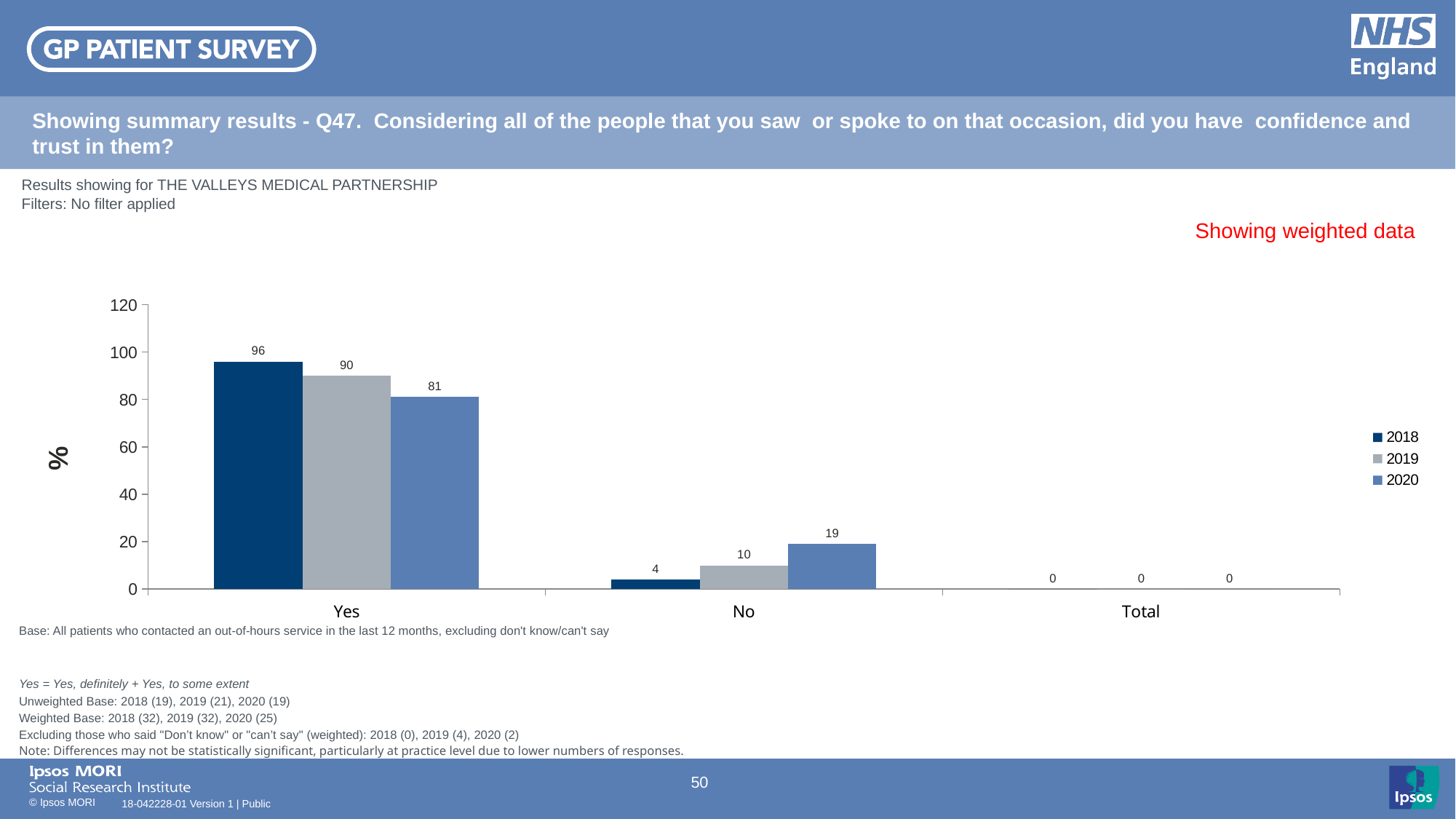
How many series does the legend list? 3 What is the value for 2020 in the No category? 19 What is the label on the y axis? % Which year has the lowest value in the No category? 2018 What is the value for 2019 in the Yes category? 90 How many categories are shown on the x axis? 3 Which year has the highest value in the Yes category? 2018 What is the difference between the 2018 and 2020 values in the Yes category? 15 Which is larger in the No category, the 2019 value or the 2020 value? 2020 What is the value for 2018 in the Yes category? 96 What kind of chart is shown on the slide? bar chart Is the value for 2020 in the Yes category greater or less than 100? less